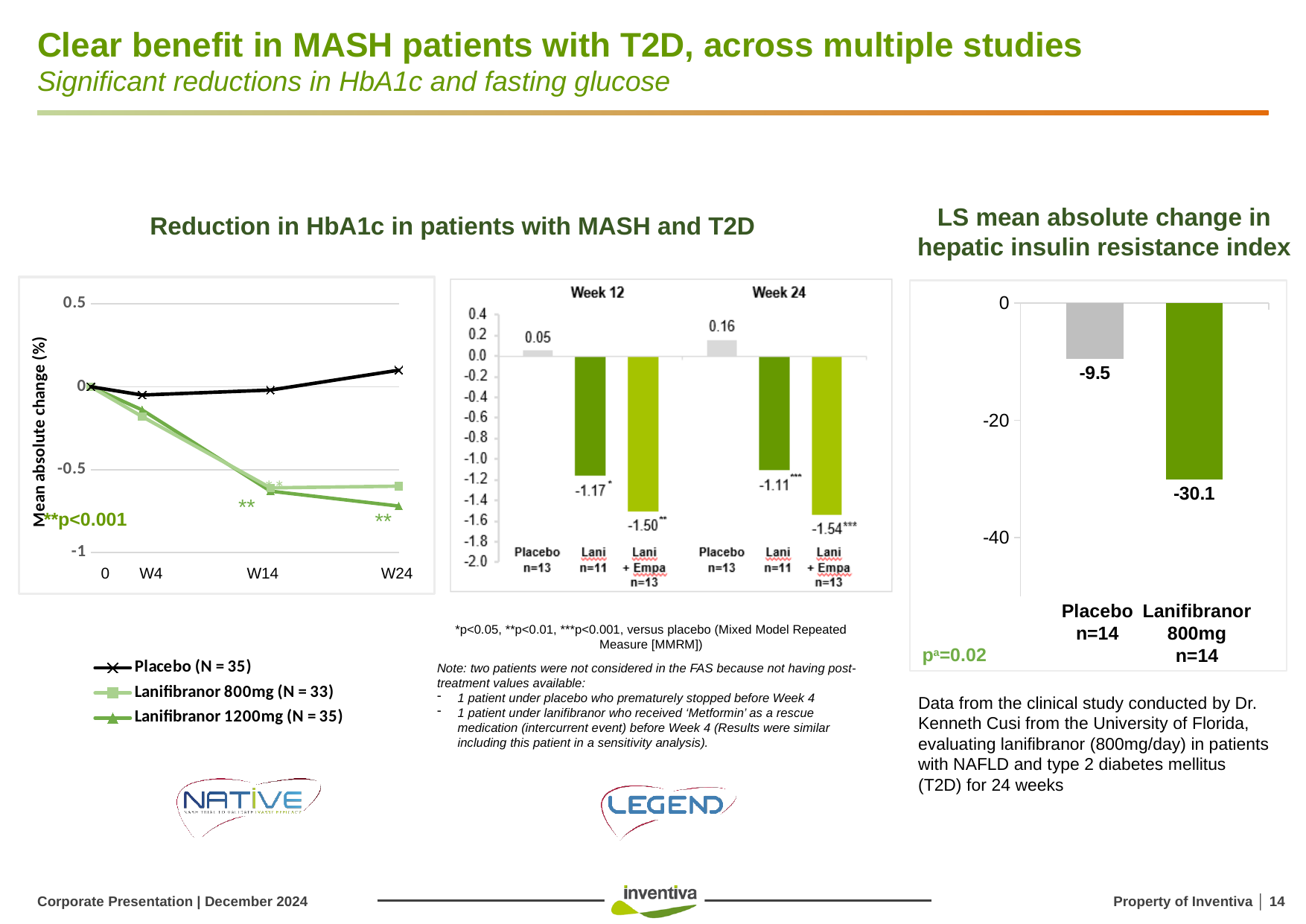
In the middle bar chart (Week 12 / Week 24), what is the difference between the Placebo value at Week 24 and the Placebo value at Week 12? 0.11 In the chart titled 'Reduction in HbA1c in patients with MASH and T2D' (left line chart), is the value for Lanifibranor 1200mg at W24 greater or less than -0.5? less In the chart titled 'LS mean absolute change in hepatic insulin resistance index', what is the difference between the Placebo value and the Lanifibranor 800mg value? 20.6 In the middle bar chart (Week 12 / Week 24), what is the value for Placebo at Week 12? 0.05 In the middle bar chart (Week 12 / Week 24), what is the value for Lani at Week 24? -1.11 In the middle bar chart (Week 12 / Week 24), how many bars are plotted in total? 6 In the chart titled 'LS mean absolute change in hepatic insulin resistance index', what kind of chart is shown? Bar chart In the chart titled 'Reduction in HbA1c in patients with MASH and T2D' (left line chart), do the Lanifibranor 800mg values rise or fall from 0 to W14? fall In the chart titled 'Reduction in HbA1c in patients with MASH and T2D' (left line chart), how many series does the legend list? 3 In the middle bar chart (Week 12 / Week 24), which bar has the lowest value? Lani + Empa at Week 24 In the middle bar chart (Week 12 / Week 24), what is the value for Lani + Empa at Week 24? -1.54 In the chart titled 'LS mean absolute change in hepatic insulin resistance index', what is the value for Lanifibranor 800mg? -30.1